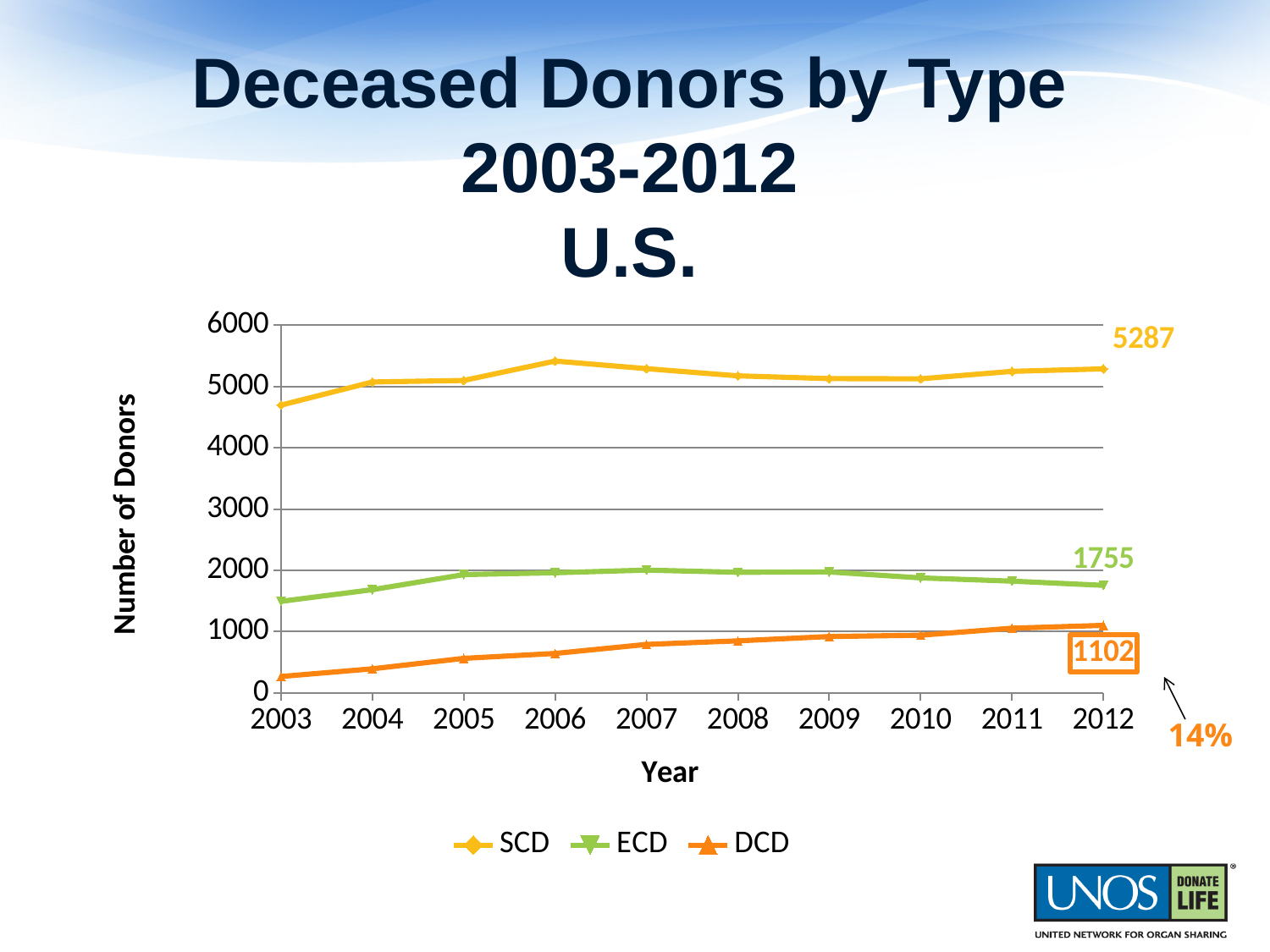
Is the value for SCD in 2006 greater or less than 5000? greater What is the difference between the SCD and ECD values in 2012? 3532 What is the difference between the ECD and DCD values in 2012? 653 How many series does the legend list? 3 What kind of chart is shown on the slide? Line chart Which series has the lowest values across the chart? DCD How many years are shown on the x axis? 10 What is the value for DCD in 2012? 1102 What is the value for ECD in 2012? 1755 Is the value for DCD in 2003 greater or less than 1000? less Which series has the highest values across the chart? SCD What is the value for SCD in 2012? 5287